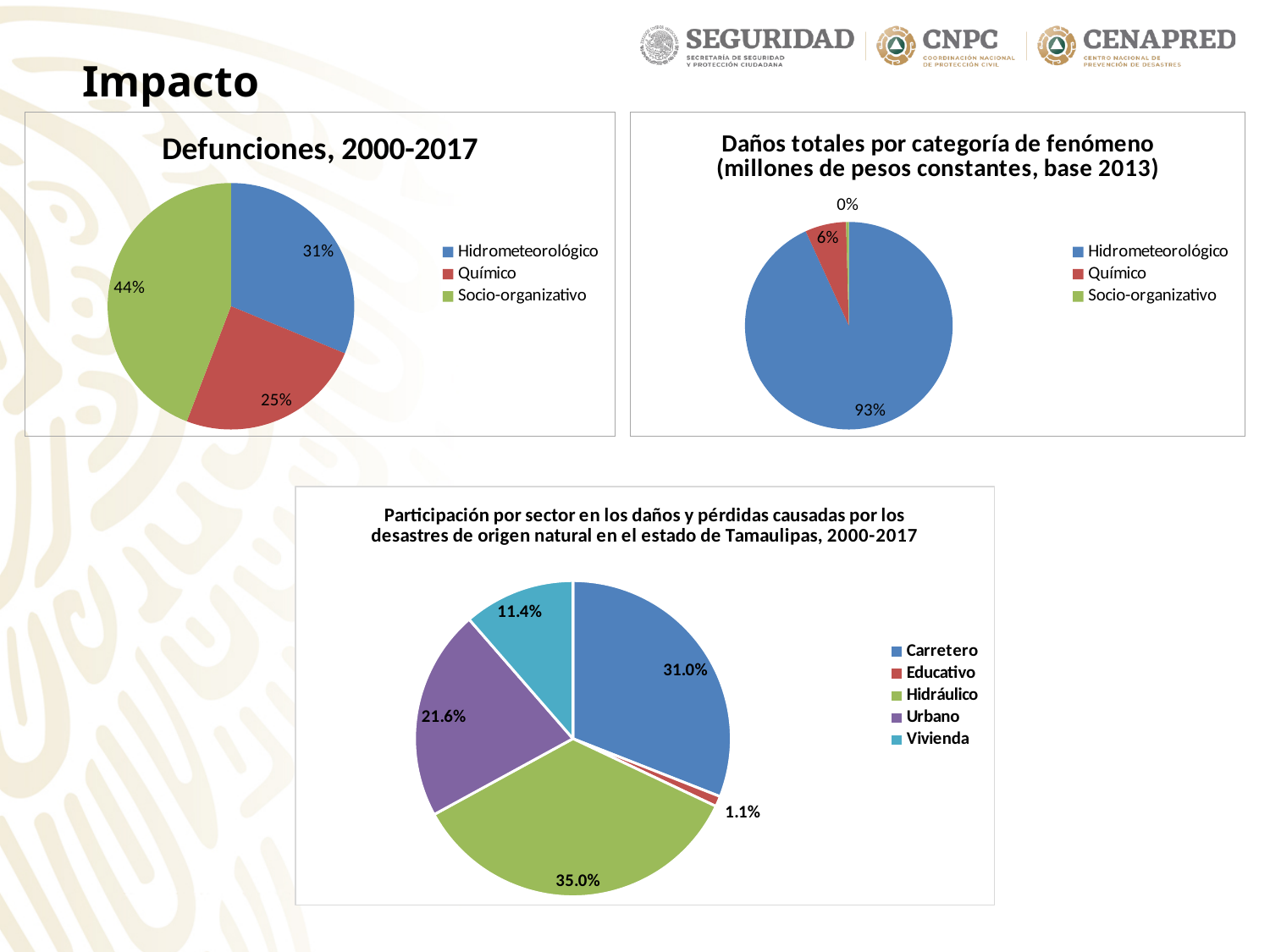
In the 'Daños totales por categoría de fenómeno' chart, what share is Químico? 6% In the 'Defunciones, 2000-2017' chart, which category has the largest share? Socio-organizativo In the 'Participación por sector' chart, what share is Hidráulico? 35.0% In the 'Participación por sector' chart, what share is Educativo? 1.1% In the 'Daños totales por categoría de fenómeno' chart, which category has the smallest share? Socio-organizativo In the 'Daños totales por categoría de fenómeno' chart, what share is Hidrometeorológico? 93% In the 'Participación por sector' chart, which sector has the largest share? Hidráulico What kind of chart is the 'Participación por sector' chart? Pie chart In the 'Defunciones, 2000-2017' chart, what share is Socio-organizativo? 44% In the 'Defunciones, 2000-2017' chart, what is the difference between the Socio-organizativo and Hidrometeorológico shares? 13% In the 'Defunciones, 2000-2017' chart, what share is Químico? 25% In the 'Participación por sector' chart, how many sectors does the legend list? 5